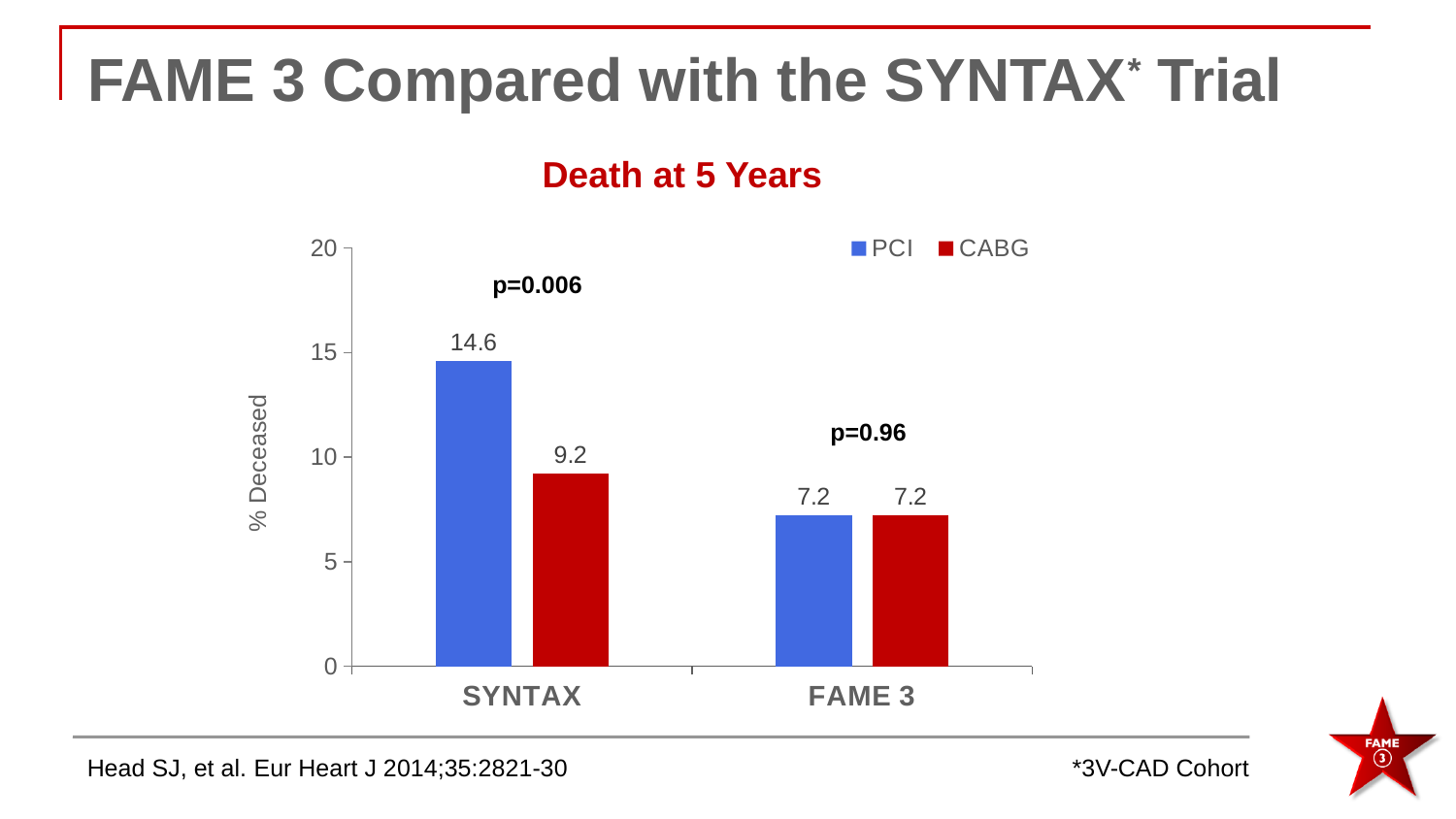
What is the title of the chart? Death at 5 Years What is the difference between the PCI and CABG values for SYNTAX? 5.4 Is the PCI value for SYNTAX greater or less than 10? greater What is the PCI value for FAME 3? 7.2 Which is larger for SYNTAX, the PCI value or the CABG value? PCI What is the PCI value for SYNTAX? 14.6 How many categories are shown on the x axis? 2 What is the CABG value for SYNTAX? 9.2 Which bar has the highest value in the chart? PCI for SYNTAX What is the CABG value for FAME 3? 7.2 What kind of chart is shown on the slide? Bar chart How many series does the legend list? 2